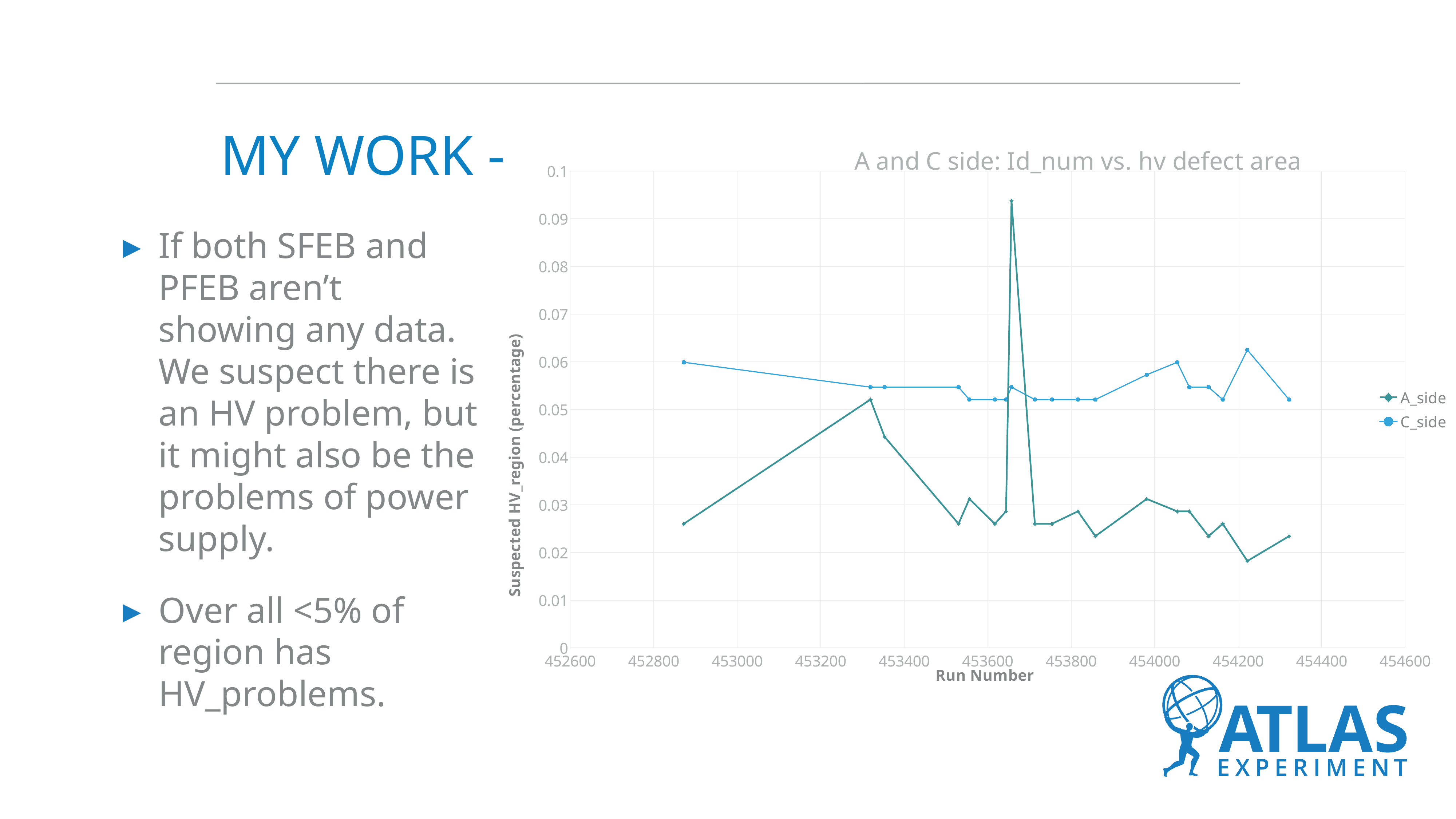
Is the peak value of the A_side series greater or less than 0.09? greater Are all values of the C_side series greater or less than 0.07? less Is the lowest value of the A_side series greater or less than 0.02? less Which series reaches the lowest value on the chart? A_side What kind of chart is shown on the slide? Line chart Between the first two plotted points (around run 452880 to 453320), does the A_side series rise or fall? rise What is the title of the chart? A and C side: Id_num vs. hv defect area What is the label of the chart's x axis? Run Number At the first plotted run number, near 452880, which series has the higher value, A_side or C_side? C_side Which series reaches the highest value on the chart? A_side How many series does the chart's legend list? 2